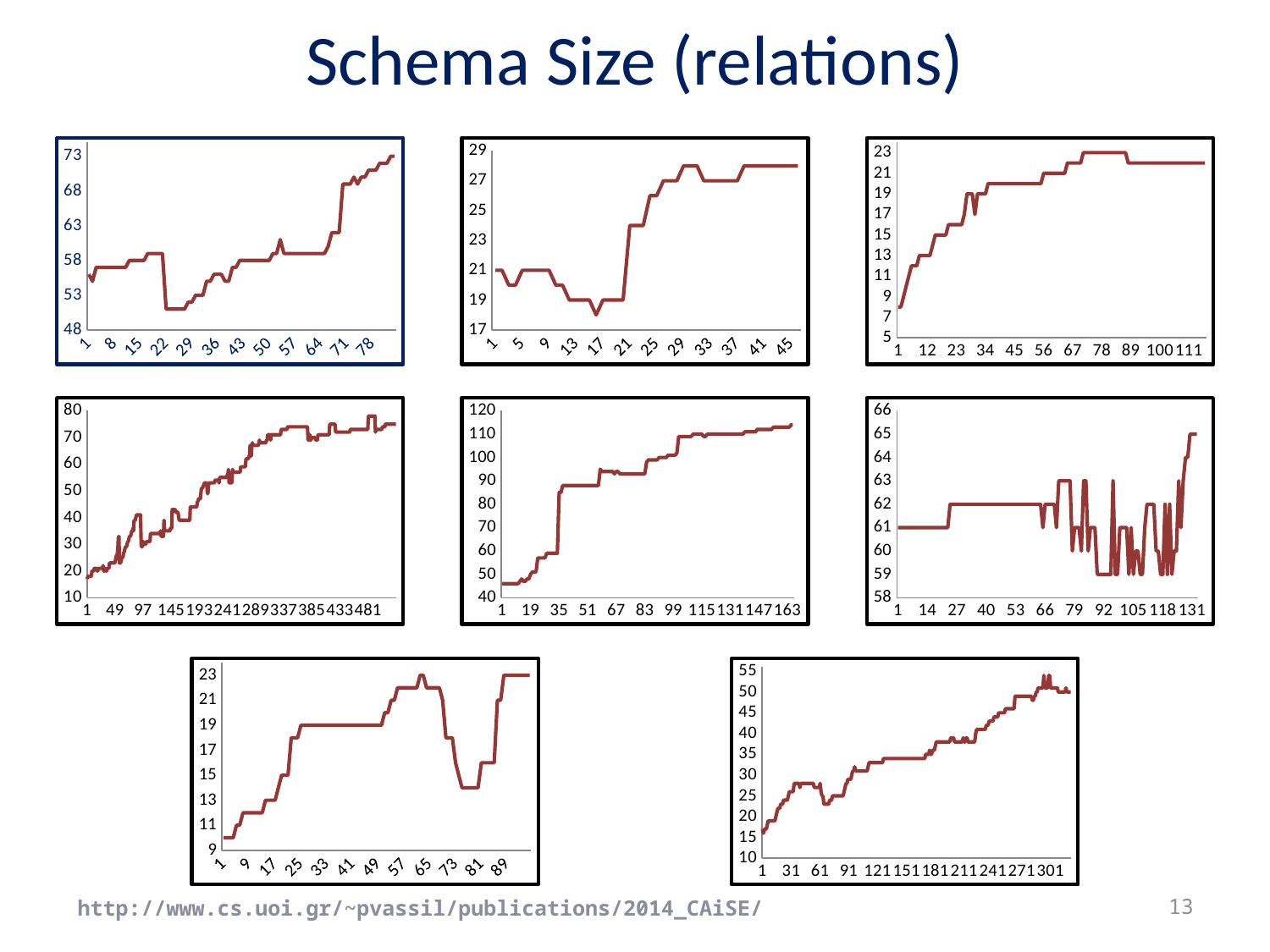
In the middle-right chart, is the value at x = 1 greater or less than 60? greater In the top-middle chart, is the value at x = 45 greater or less than 27? greater In the middle chart of the middle row, is the value at x = 163 greater or less than 100? greater In the top-left chart, do the values overall rise or fall from left to right along the x axis? rise How many charts are shown on the slide? 8 In the bottom-left chart, do the values overall rise or fall from x = 1 to x = 89? rise What is the title of the slide above the charts? Schema Size (relations) What kind of chart is the top-left chart on the slide? line chart